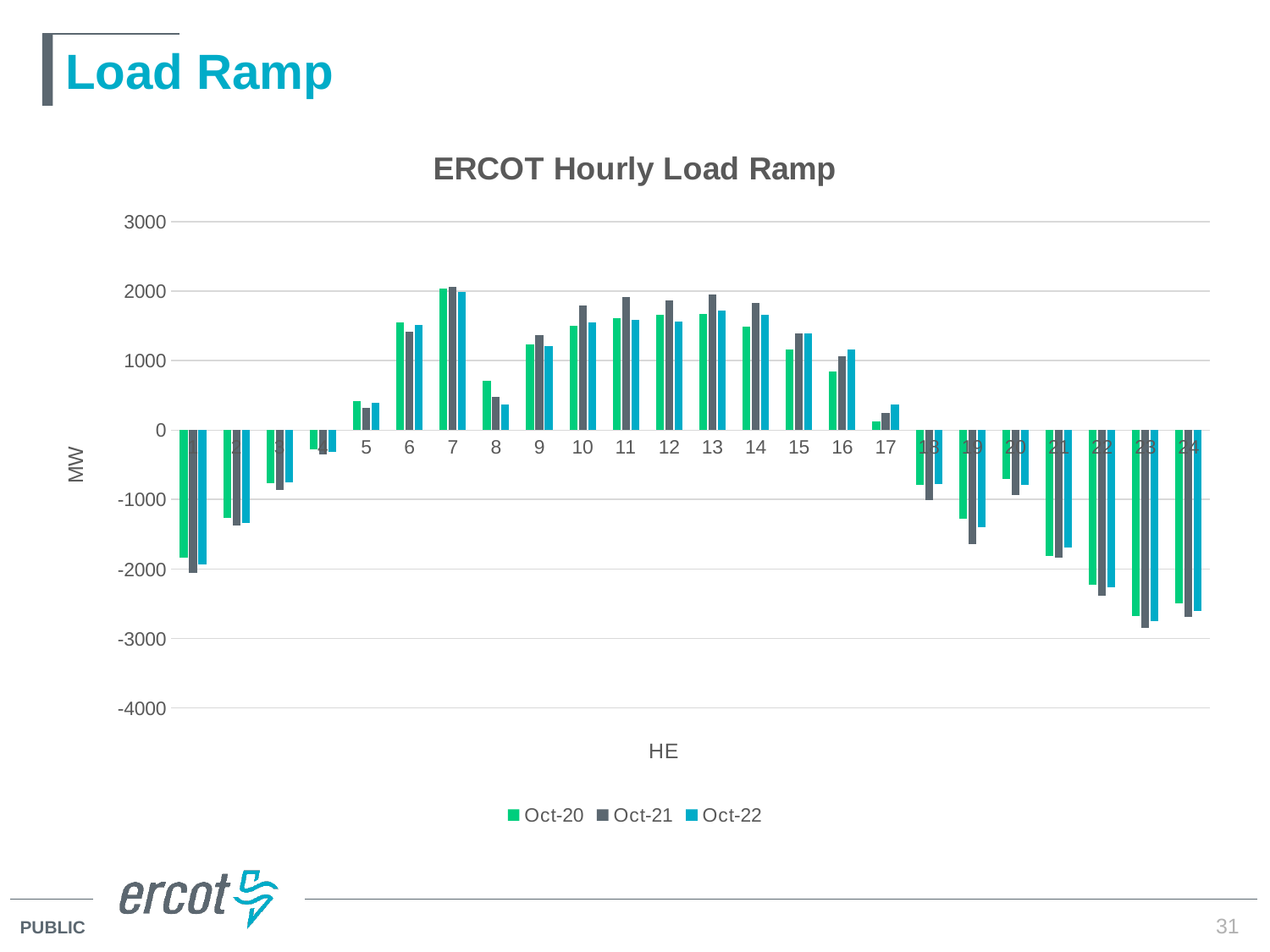
At HE 16, which series has the larger value, Oct-20 or Oct-22? Oct-22 Is the Oct-20 value for HE 6 greater or less than 1000? greater For which hour (HE) is the Oct-20 value highest? 7 What is the label on the y axis? MW Do the Oct-21 values rise or fall from HE 18 to HE 23? fall Is the Oct-21 value for HE 23 greater or less than -2000? less How many hours (HE categories) are plotted along the x axis? 24 What kind of chart is shown on the slide? bar chart Is the Oct-21 value for HE 19 greater or less than -1000? less For which hour (HE) is the Oct-21 value lowest? 23 How many series does the legend list? 3 What is the title of the chart? ERCOT Hourly Load Ramp